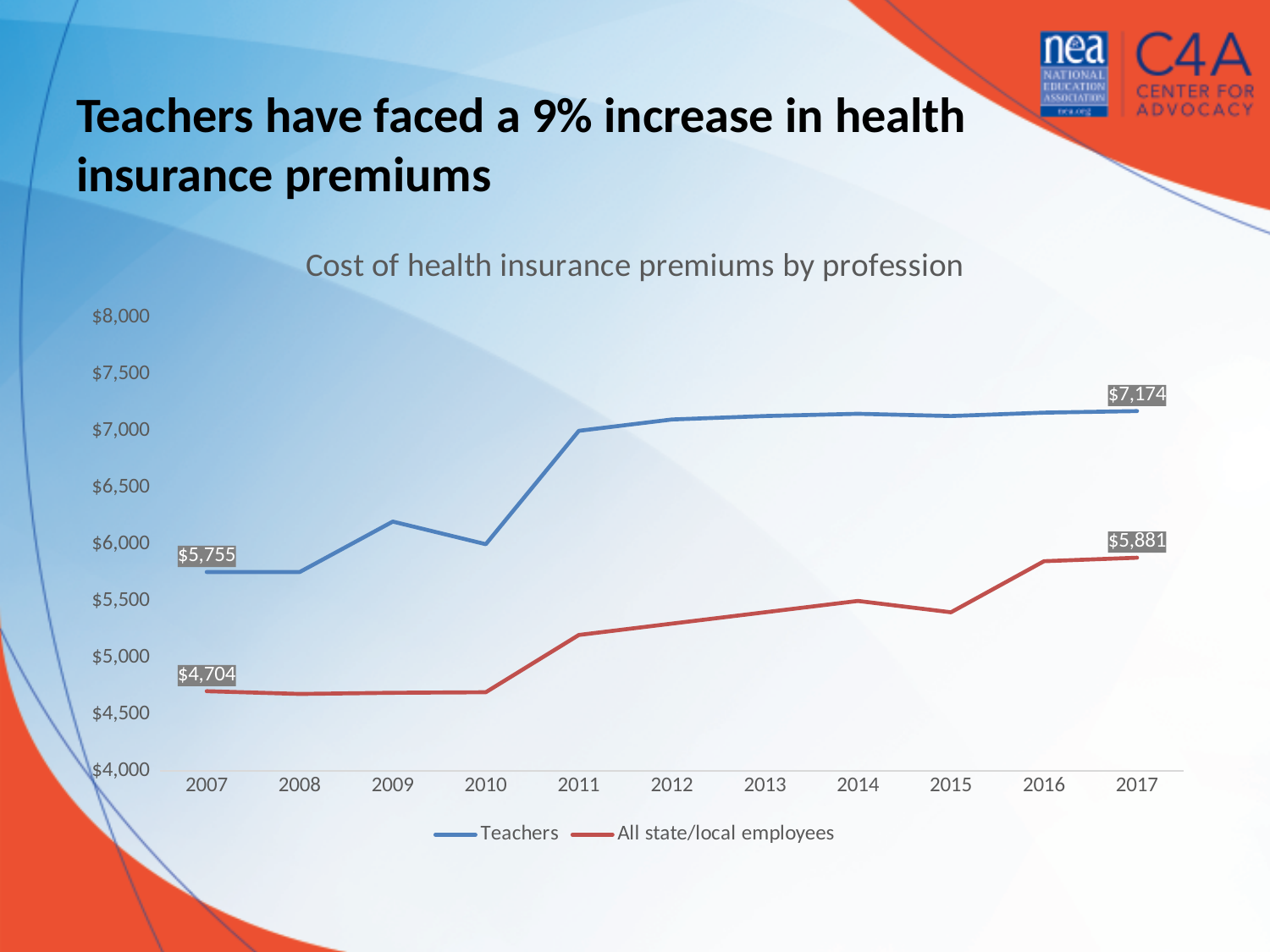
How many series does the chart's legend list? 2 What type of chart is shown on the slide? Line chart What is the cost of health insurance premiums for Teachers in 2007? $5,755 What is the cost of health insurance premiums for All state/local employees in 2017? $5,881 In 2017, which series has the higher premium, Teachers or All state/local employees? Teachers How many years are shown on the x axis of the chart? 11 What is the difference between the Teachers premium and the All state/local employees premium in 2017? $1,293 Is the Teachers premium in 2011 greater or less than $6,500? greater What is the cost of health insurance premiums for All state/local employees in 2007? $4,704 By how much did the Teachers premium increase from 2007 to 2017? $1,419 What is the cost of health insurance premiums for Teachers in 2017? $7,174 Is the All state/local employees premium in 2010 greater or less than $5,000? less